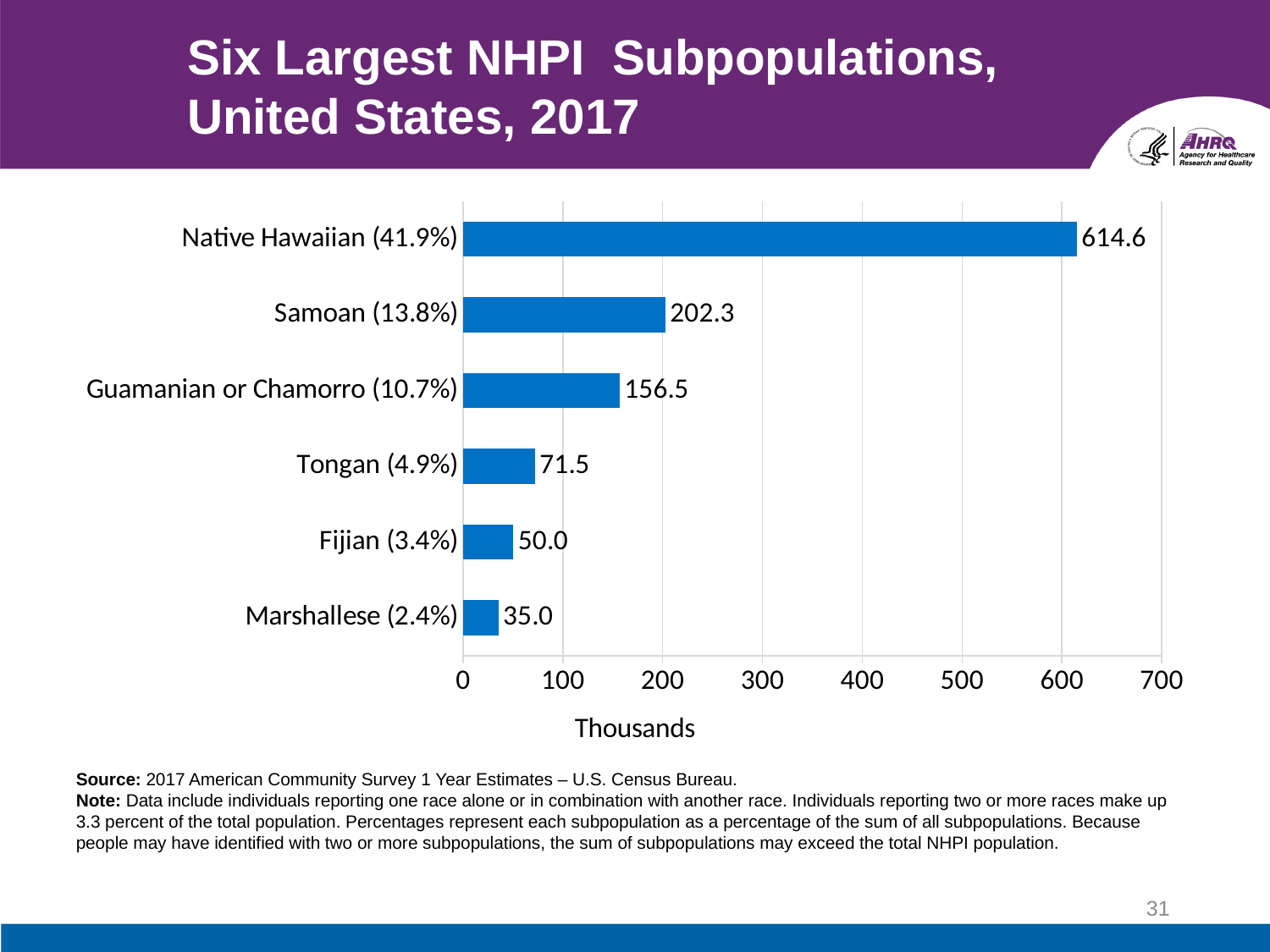
What is the value for Tongan (4.9%)? 71.5 What is the difference between the values for Fijian (3.4%) and Marshallese (2.4%)? 15.0 What is the value for Native Hawaiian (41.9%)? 614.6 What is the value for Guamanian or Chamorro (10.7%)? 156.5 What is the value for Samoan (13.8%)? 202.3 Which subpopulation has the highest value? Native Hawaiian (41.9%) How many subpopulations are shown in the chart? 6 Which subpopulation has the lowest value? Marshallese (2.4%) What is the label on the horizontal axis of the chart? Thousands Which is larger, the value for Tongan (4.9%) or the value for Fijian (3.4%)? Tongan (4.9%) What is the difference between the values for Samoan (13.8%) and Guamanian or Chamorro (10.7%)? 45.8 What kind of chart is shown on the slide? Bar chart